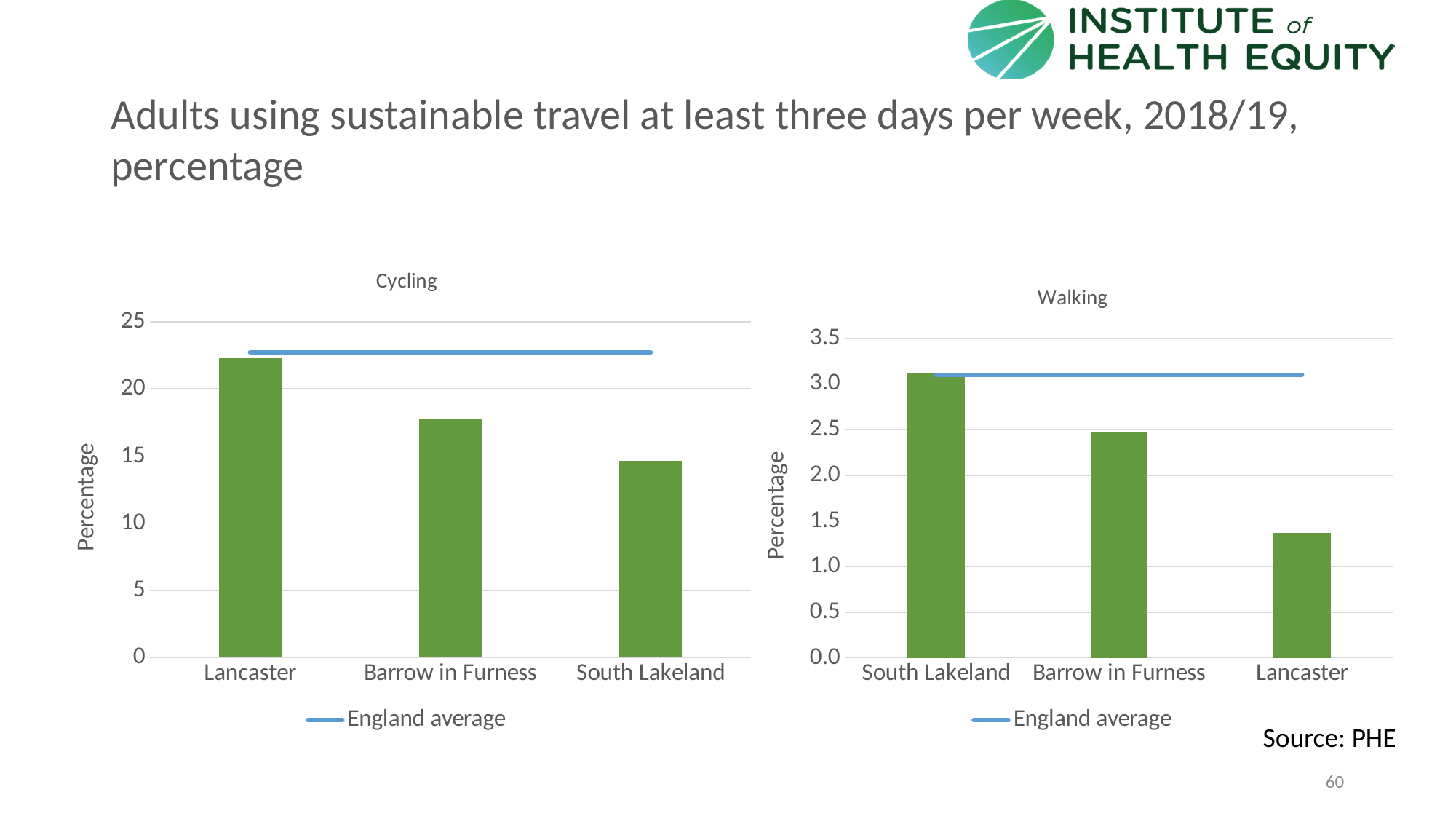
In the Cycling chart, is the value for Barrow in Furness greater or less than 15? greater How many areas are shown on the x axis of the Walking chart? 3 In the Walking chart, is the value for Lancaster greater or less than 1.5? less In the Walking chart, what does the blue horizontal line represent according to the legend? England average In the Cycling chart, which area has the highest value? Lancaster In the Walking chart, which area has the lowest value? Lancaster In the Walking chart, is the value for Barrow in Furness greater or less than 2.0? greater In the Cycling chart, which is larger, the value for Lancaster or the value for Barrow in Furness? Lancaster In the Cycling chart, which area has the lowest value? South Lakeland In the Walking chart, which area has the highest value? South Lakeland What kind of chart is the Cycling chart? Bar chart